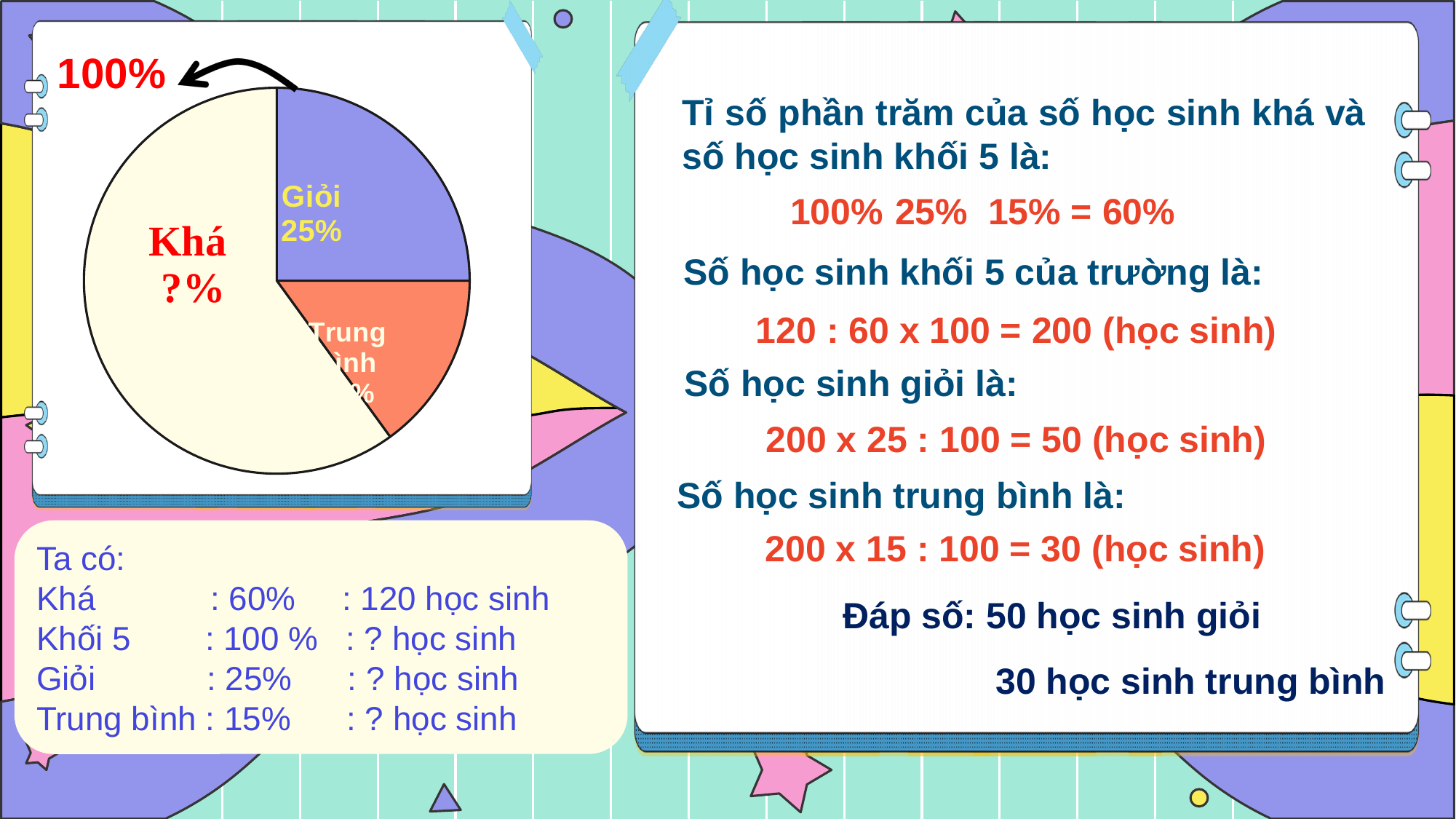
Is the Khá slice's share of the pie greater or less than 50%? greater According to the slide, what percentage does the Khá slice represent? 60% How many slices does the pie chart have? 3 What percentage does the arrow pointing at the whole pie chart indicate? 100% Which slice is larger in the pie chart, Giỏi or Trung bình? Giỏi What label is printed inside the Khá slice of the pie chart below the word Khá? ? % Which slice of the pie chart is the largest? Khá According to the slide, what percentage does the Trung bình slice represent? 15% What percentage is shown for the Giỏi slice of the pie chart? 25% Which slice of the pie chart is the smallest? Trung bình What kind of chart is shown on the slide? pie chart